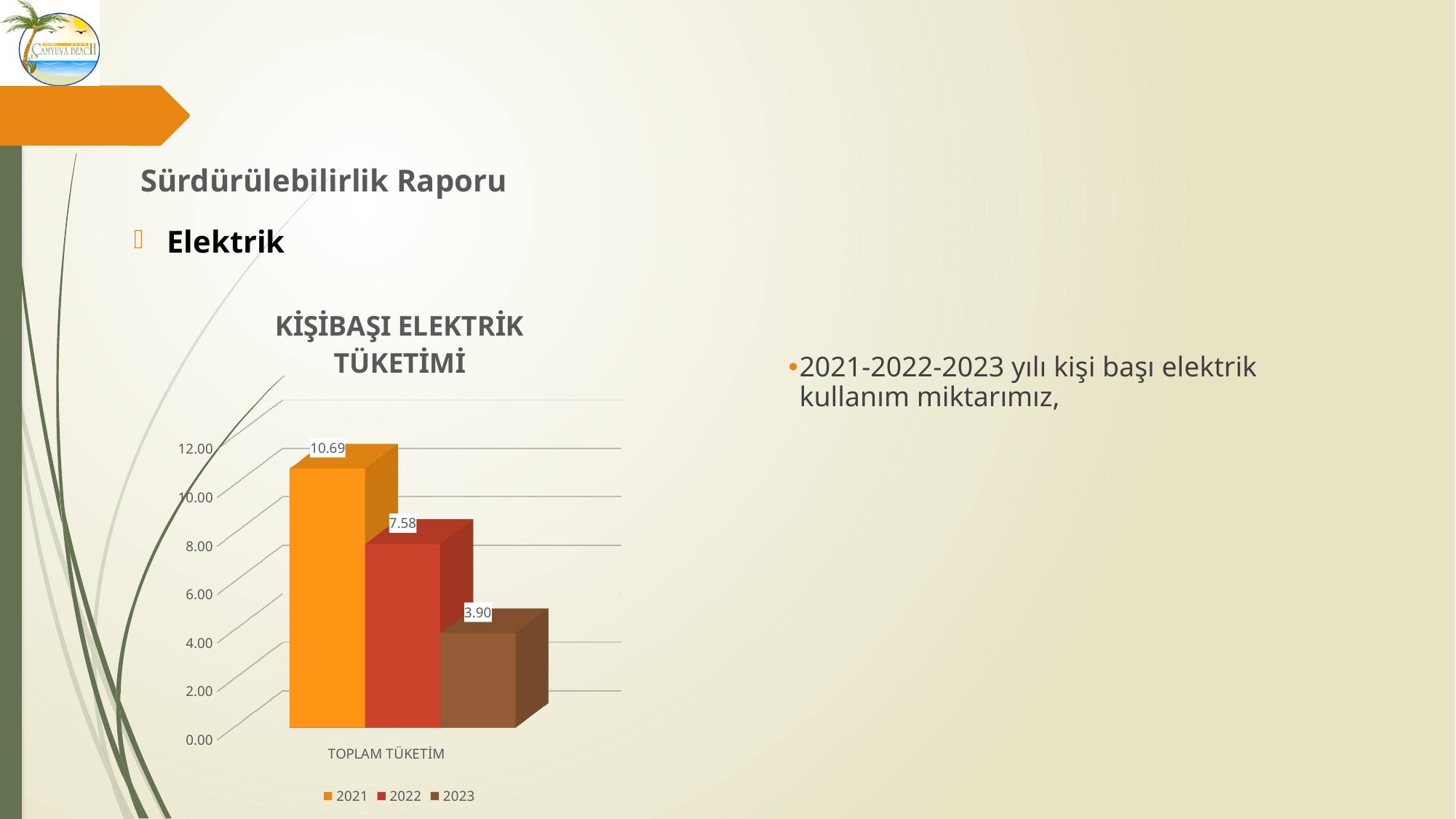
What is the difference between the 2021 and 2022 values in the KİŞİBAŞI ELEKTRİK TÜKETİMİ chart? 3.11 Which year has the lowest value in the KİŞİBAŞI ELEKTRİK TÜKETİMİ chart? 2023 What is the value for 2021 in the KİŞİBAŞI ELEKTRİK TÜKETİMİ chart? 10.69 Do the values in the KİŞİBAŞI ELEKTRİK TÜKETİMİ chart rise or fall from 2021 to 2023? Fall What is the value for 2023 in the KİŞİBAŞI ELEKTRİK TÜKETİMİ chart? 3.90 How many series does the legend of the KİŞİBAŞI ELEKTRİK TÜKETİMİ chart list? 3 Which year has the highest value in the KİŞİBAŞI ELEKTRİK TÜKETİMİ chart? 2021 What kind of chart is the KİŞİBAŞI ELEKTRİK TÜKETİMİ chart? Bar chart Which is larger in the KİŞİBAŞI ELEKTRİK TÜKETİMİ chart, the value for 2022 or the value for 2023? 2022 What is the value for 2022 in the KİŞİBAŞI ELEKTRİK TÜKETİMİ chart? 7.58 What is the difference between the 2022 and 2023 values in the KİŞİBAŞI ELEKTRİK TÜKETİMİ chart? 3.68 Is the value for 2021 in the KİŞİBAŞI ELEKTRİK TÜKETİMİ chart greater or less than 10.00? greater